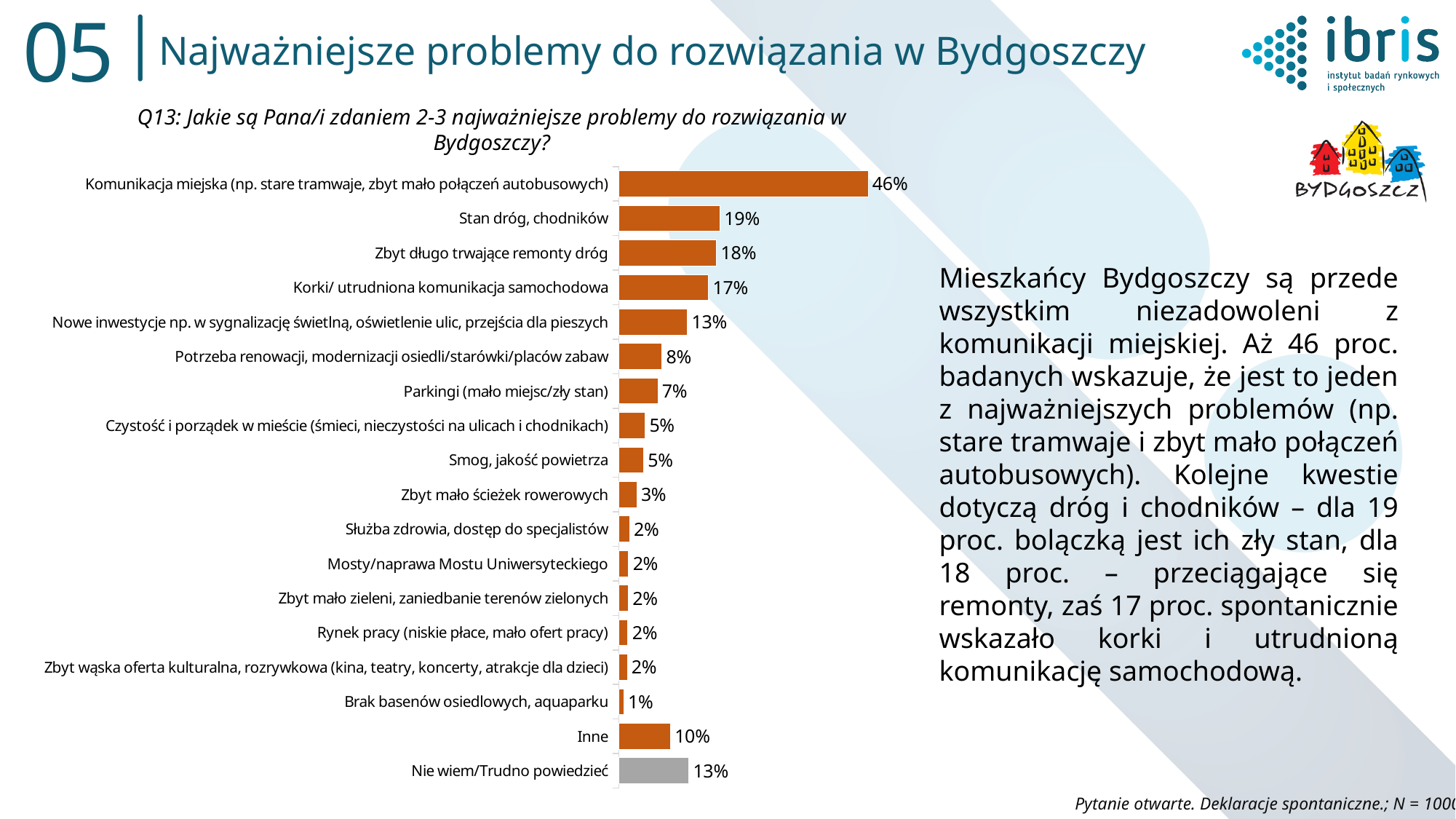
Which category has the lowest value in the chart? Brak basenów osiedlowych, aquaparku Which is larger: the value for "Parkingi (mało miejsc/zły stan)" or for "Potrzeba renowacji, modernizacji osiedli/starówki/placów zabaw"? Potrzeba renowacji, modernizacji osiedli/starówki/placów zabaw What is the value shown for "Stan dróg, chodników"? 19% What percentage of respondents named "Komunikacja miejska" as one of the most important problems? 46% What is the difference between the values for "Komunikacja miejska" and "Stan dróg, chodników"? 27 percentage points What is the value shown for "Korki/ utrudniona komunikacja samochodowa"? 17% What is the value shown for "Inne"? 10% How many categories are shown in the chart? 18 Which bar in the chart is coloured grey instead of orange? Nie wiem/Trudno powiedzieć What type of chart is shown on the slide? Bar chart Which category has the highest value in the chart? Komunikacja miejska (np. stare tramwaje, zbyt mało połączeń autobusowych) What is the value shown for "Nie wiem/Trudno powiedzieć"? 13%